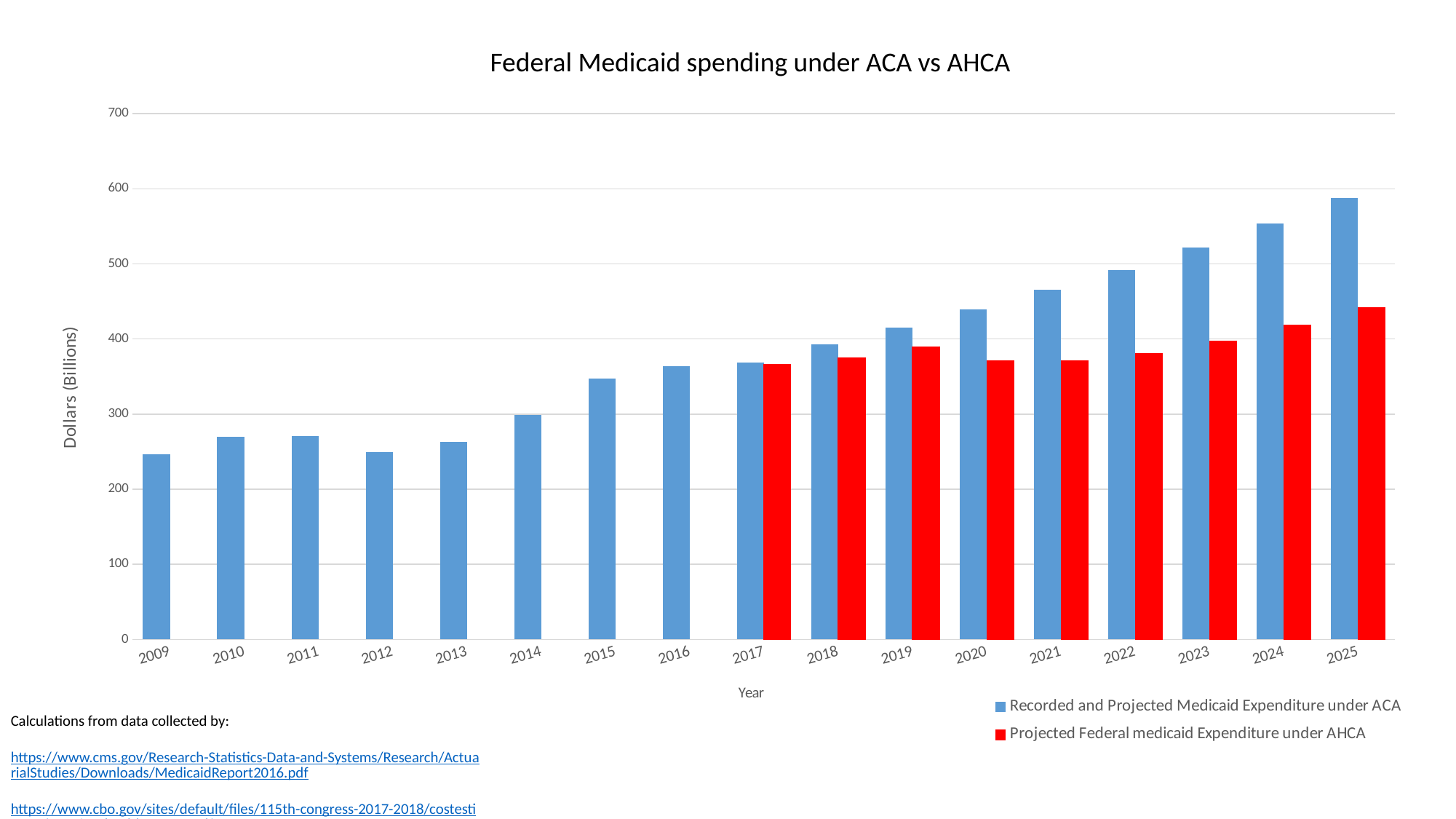
Which year has the highest value for Projected Federal medicaid Expenditure under AHCA? 2025 What is the title of the chart? Federal Medicaid spending under ACA vs AHCA Is the value for Projected Federal medicaid Expenditure under AHCA in 2025 greater or less than 400? greater Which year has the highest value for Recorded and Projected Medicaid Expenditure under ACA? 2025 Does the Recorded and Projected Medicaid Expenditure under ACA generally rise or fall from 2013 to 2025? rise In 2025, which is larger: the expenditure under ACA or the expenditure under AHCA? ACA Is the value for Recorded and Projected Medicaid Expenditure under ACA in 2025 greater or less than 500? greater How many years are shown on the x axis? 17 Is the value for Recorded and Projected Medicaid Expenditure under ACA in 2009 greater or less than 300? less How many series does the legend list? 2 What kind of chart is shown on the slide? bar chart